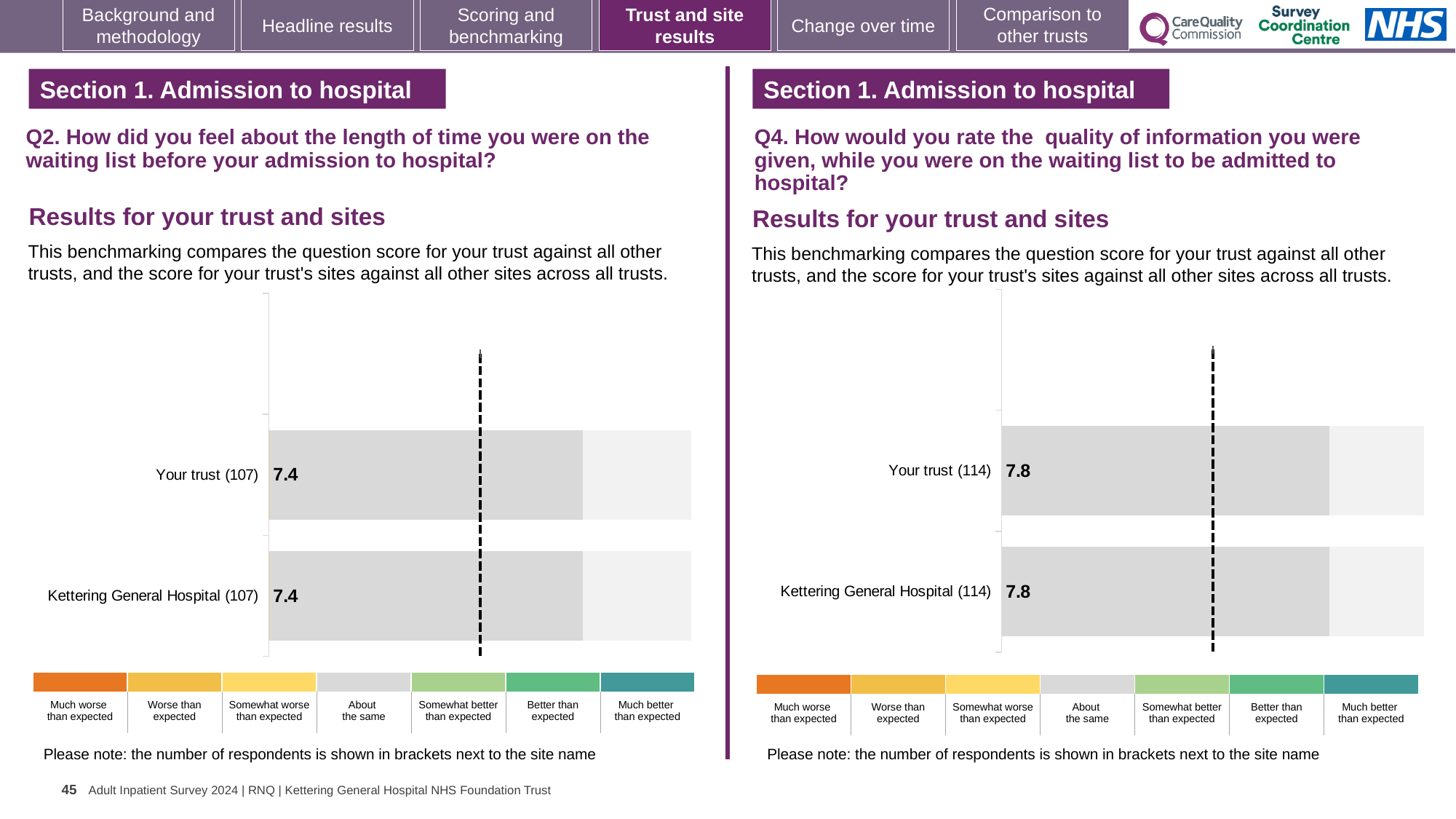
What kind of chart is used on the right (Q4)? Bar chart On the left chart (Q2), what is the score for Your trust (107)? 7.4 On the right chart (Q4), what is the score for Kettering General Hospital (114)? 7.8 How many bars are plotted on the left chart (Q2)? 2 What kind of chart is used on the left (Q2)? Bar chart On the right chart (Q4), what is the score for Your trust (114)? 7.8 On the left chart (Q2), what is the difference between the score for Your trust and the score for Kettering General Hospital? 0 On the right chart (Q4), what is the difference between the score for Your trust and the score for Kettering General Hospital? 0 How many bars are plotted on the right chart (Q4)? 2 How many respondents are shown in brackets for Your trust on the right chart (Q4)? 114 On the left chart (Q2), what is the score for Kettering General Hospital (107)? 7.4 How many respondents are shown in brackets for Kettering General Hospital on the left chart (Q2)? 107